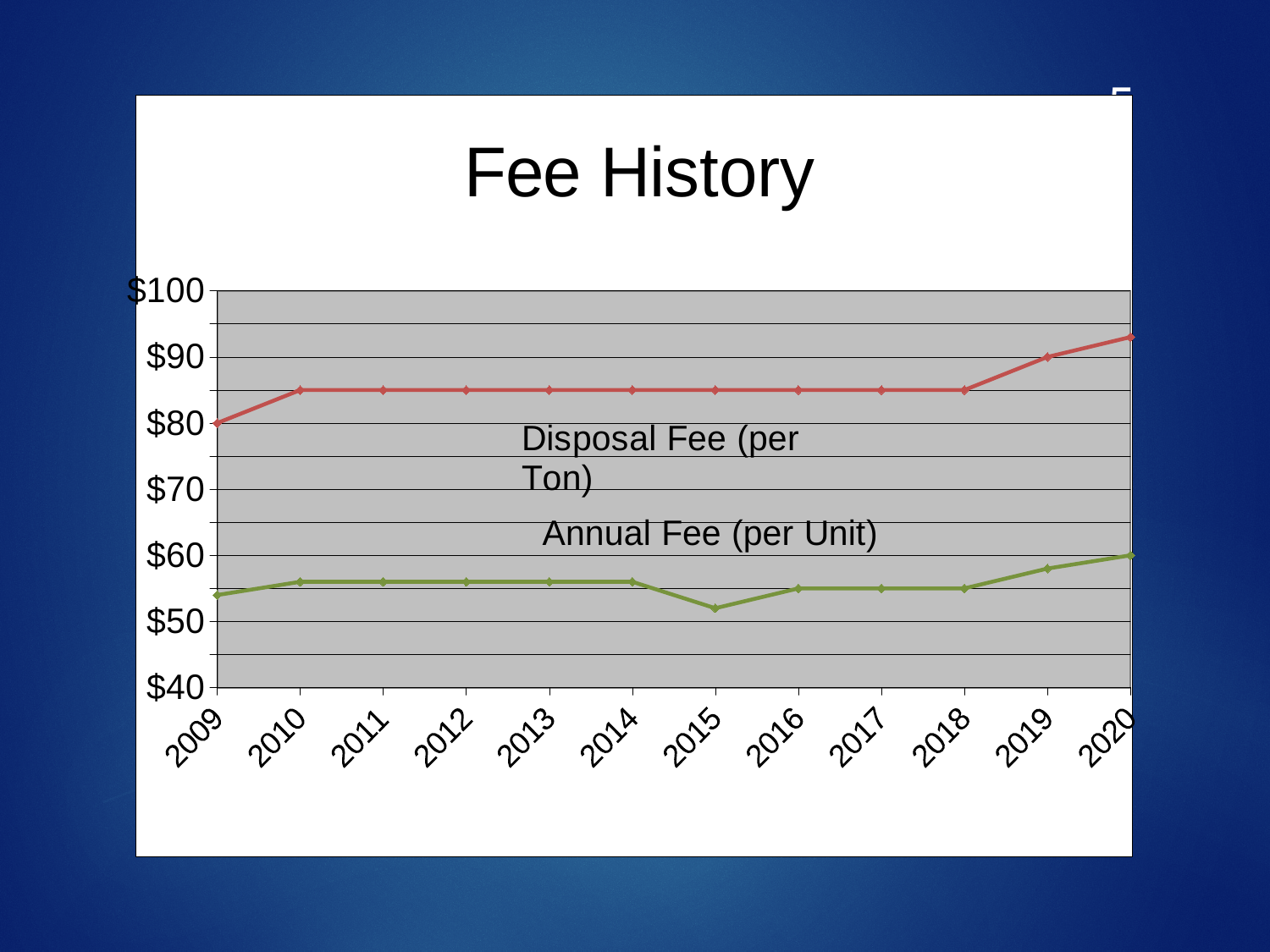
How many series are plotted in the chart? 2 What is the Disposal Fee (per Ton) in 2019? $90 What is the Annual Fee (per Unit) in 2020? $60 How many years are shown along the x axis? 12 Is the Annual Fee (per Unit) in 2015 greater or less than $60? less Is the Disposal Fee (per Ton) in 2020 greater or less than $90? greater In 2020, which is larger: the Disposal Fee (per Ton) or the Annual Fee (per Unit)? Disposal Fee (per Ton) In which year is the Annual Fee (per Unit) lowest? 2015 What kind of chart is shown on the slide? line chart What is the title of the chart? Fee History What is the Disposal Fee (per Ton) in 2009? $80 In which year is the Disposal Fee (per Ton) highest? 2020